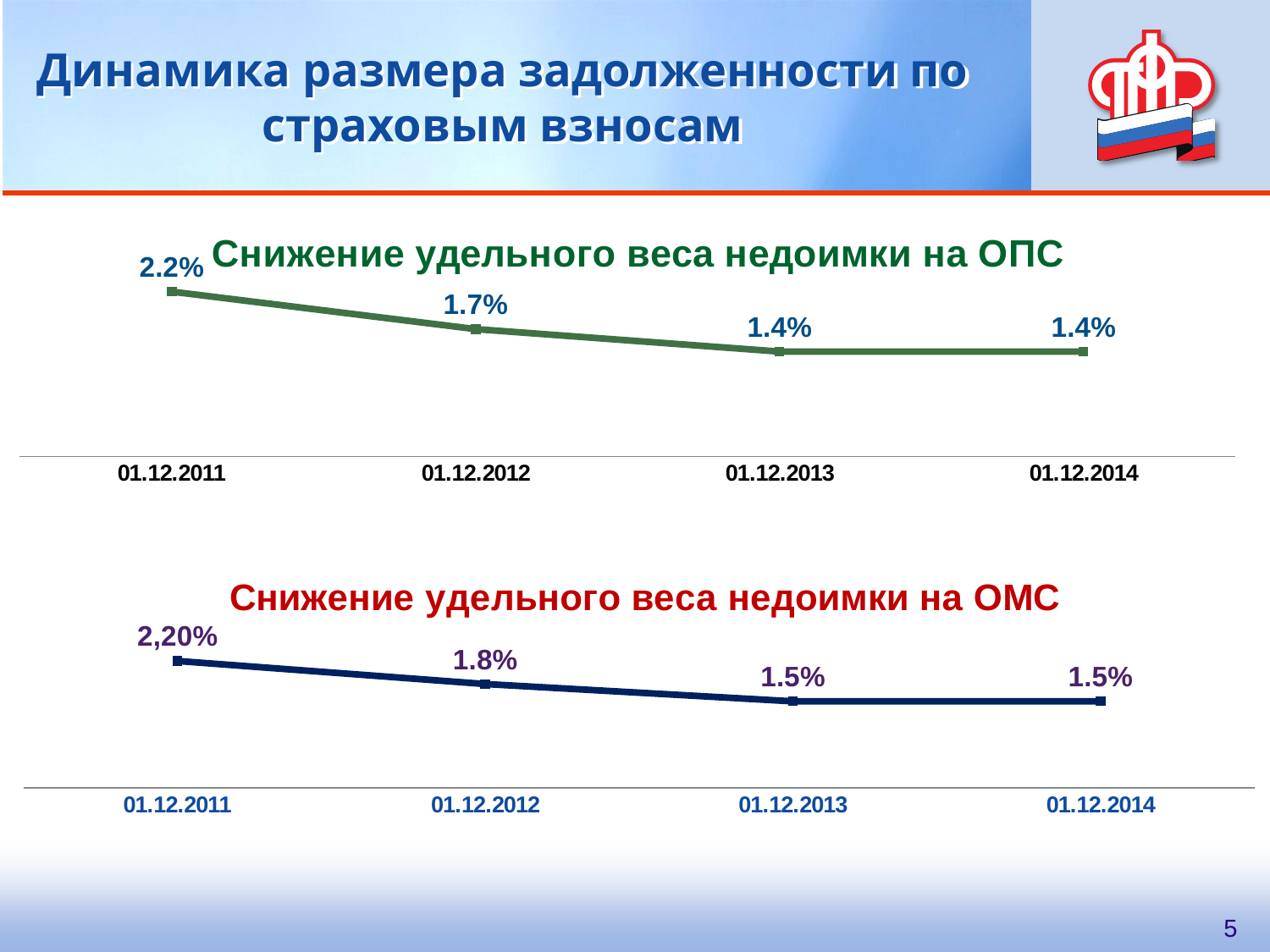
In the chart 'Снижение удельного веса недоимки на ОПС', do the values rise or fall from 01.12.2011 to 01.12.2014? Fall In the chart 'Снижение удельного веса недоимки на ОМС', what is the value for 01.12.2013? 1.5% How many data points are plotted in the chart 'Снижение удельного веса недоимки на ОПС'? 4 What kind of chart is 'Снижение удельного веса недоимки на ОМС'? Line chart In the chart 'Снижение удельного веса недоимки на ОМС', which is larger, the value for 01.12.2011 or the value for 01.12.2012? 01.12.2011 In the chart 'Снижение удельного веса недоимки на ОПС', what is the value for 01.12.2011? 2.2% In the chart 'Снижение удельного веса недоимки на ОМС', what is the value for 01.12.2011? 2,20% In the chart 'Снижение удельного веса недоимки на ОПС', what is the value for 01.12.2012? 1.7% In the chart 'Снижение удельного веса недоимки на ОПС', what is the difference between the values for 01.12.2011 and 01.12.2012? 0.5% In the chart 'Снижение удельного веса недоимки на ОМС', what is the difference between the values for 01.12.2012 and 01.12.2014? 0.3% In the chart 'Снижение удельного веса недоимки на ОМС', which date has the highest value? 01.12.2011 In the chart 'Снижение удельного веса недоимки на ОПС', which date has the highest value? 01.12.2011